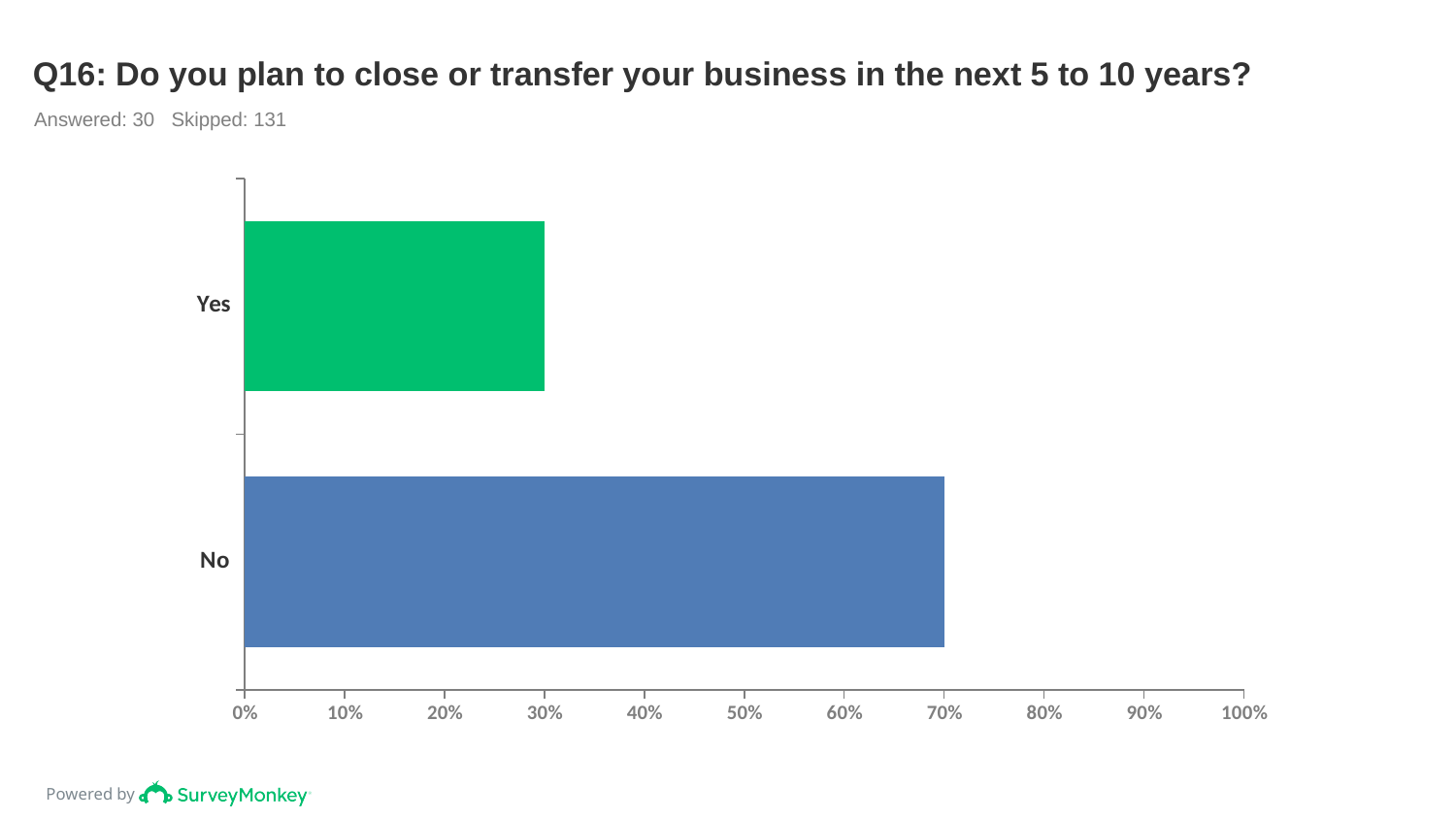
What kind of chart is shown on the slide? Bar chart What is the difference between the No and Yes percentages? 40% How many response categories are shown in the chart? 2 Which response has the highest value? No What percentage of respondents answered Yes? 30% What is the maximum value shown on the x axis? 100% How many respondents answered this question? 30 What percentage of respondents answered No? 70% Is the value for No greater or less than 50%? greater Which is larger, the value for Yes or the value for No? No Which response has the lowest value? Yes Is the value for Yes greater or less than 40%? less